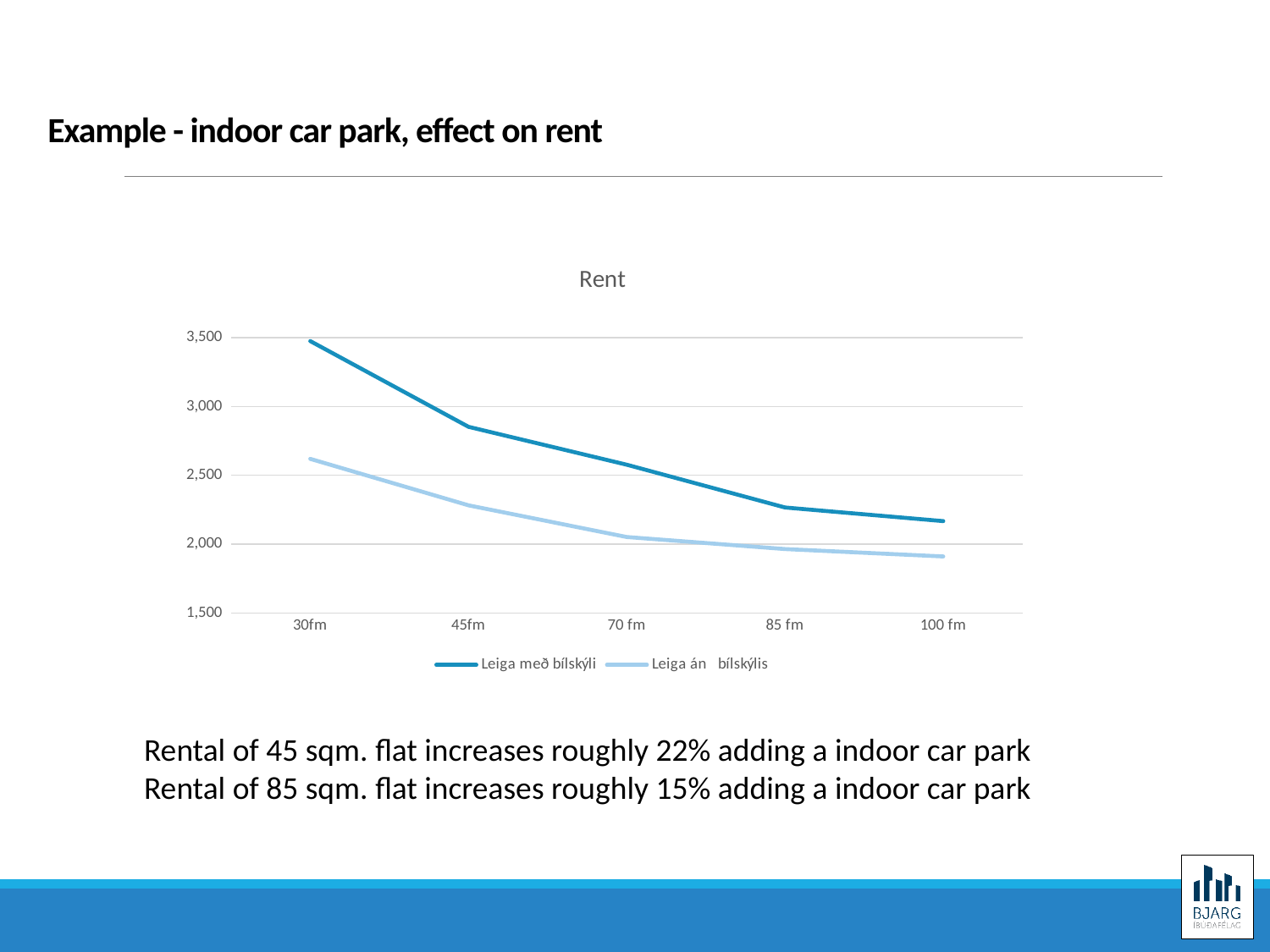
What kind of chart is shown on the slide? line chart Is the value for Leiga án bílskýlis at 45fm greater or less than 2,500? less Is the value for Leiga með bílskýli at 85 fm greater or less than 2,500? less Is the value for Leiga án bílskýlis at 100 fm greater or less than 2,000? less How many categories are shown on the x axis? 5 Do the values for Leiga með bílskýli rise or fall as flat size increases along the x axis? fall At 30fm, which series has the larger value, Leiga með bílskýli or Leiga án bílskýlis? Leiga með bílskýli At which category is the value for Leiga án bílskýlis lowest? 100 fm What is the title of the chart? Rent How many series does the legend list? 2 At which category is the value for Leiga með bílskýli highest? 30fm